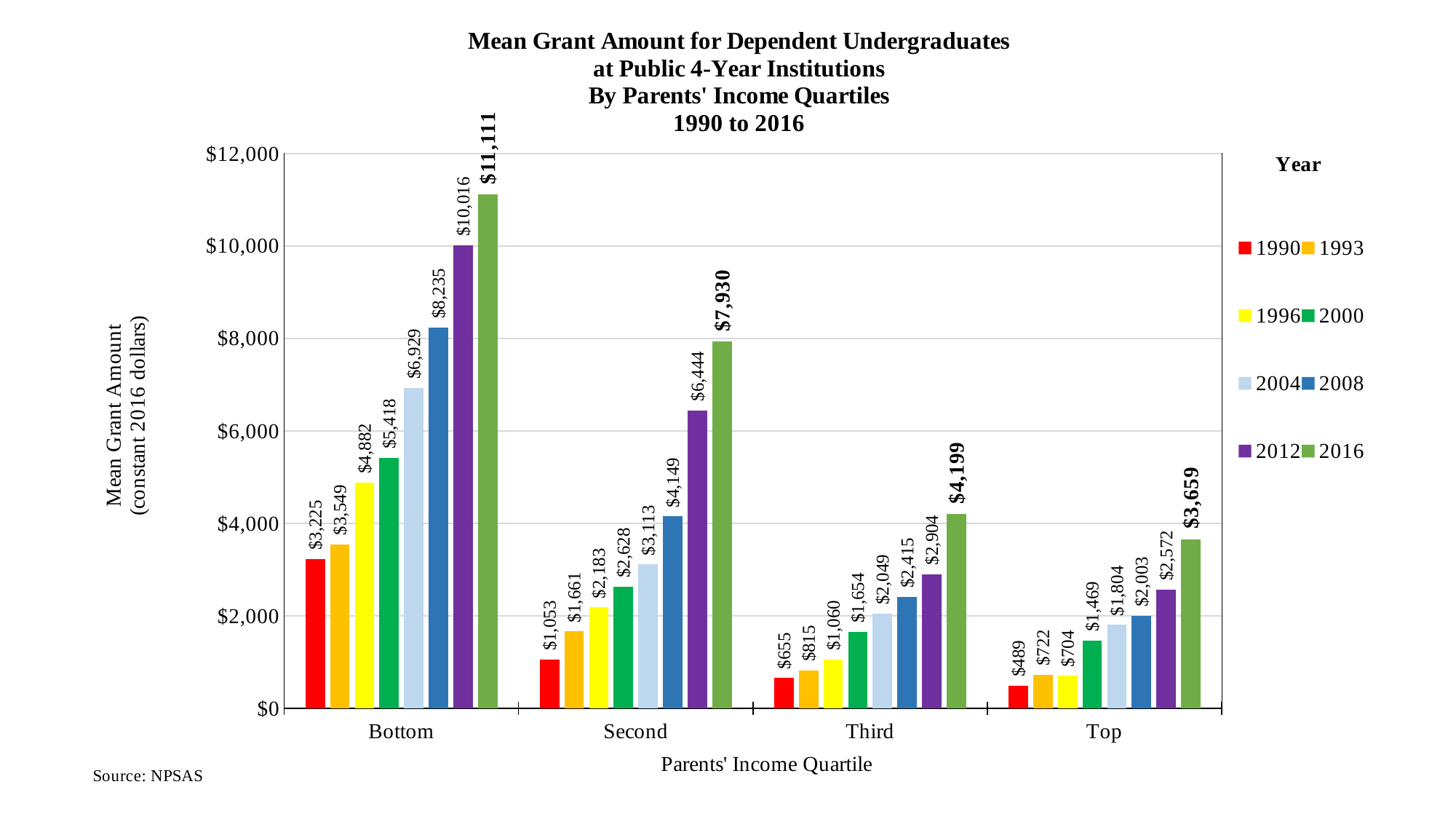
What is the mean grant amount for the Top quartile in 1990? $489 For the Second quartile, do the mean grant amounts rise or fall from 1990 to 2016? Rise Which income quartile has the lowest mean grant amount in 1990? Top What is the mean grant amount for the Second quartile in 2008? $4,149 How many income quartile categories are shown on the x axis? 4 What kind of chart is shown on the slide? Bar chart How many years does the legend list? 8 What is the mean grant amount for the Bottom quartile in 2016? $11,111 Which is larger: the 2016 mean grant amount for the Third quartile or for the Top quartile? Third What is the difference between the 2016 and 2012 mean grant amounts for the Bottom quartile? $1,095 Which income quartile has the highest mean grant amount in 2016? Bottom What is the mean grant amount for the Third quartile in 2004? $2,049